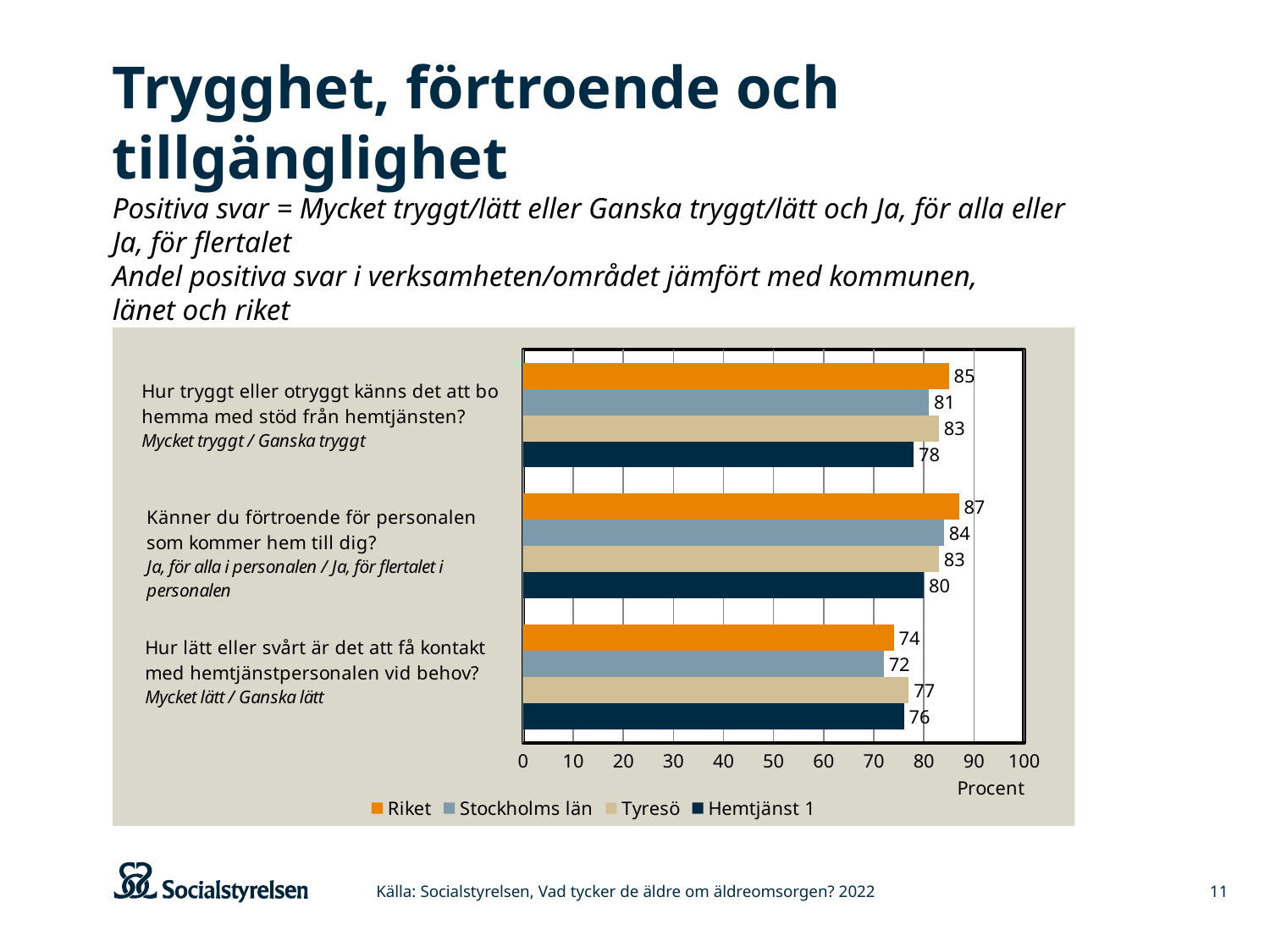
What is the difference between Riket and Hemtjänst 1 on the question "Hur tryggt eller otryggt känns det att bo hemma med stöd från hemtjänsten?"? 7 What is the value for Stockholms län on the question "Hur lätt eller svårt är det att få kontakt med hemtjänstpersonalen vid behov?"? 72 Is the value for Riket on the question "Känner du förtroende för personalen som kommer hem till dig?" greater or less than 80? greater What is the value for Tyresö on the question "Hur lätt eller svårt är det att få kontakt med hemtjänstpersonalen vid behov?"? 77 Which is larger on the question "Hur lätt eller svårt är det att få kontakt med hemtjänstpersonalen vid behov?": Tyresö or Riket? Tyresö What is the value for Riket on the question "Hur tryggt eller otryggt känns det att bo hemma med stöd från hemtjänsten?"? 85 Which series has the highest value on the question "Känner du förtroende för personalen som kommer hem till dig?"? Riket How many question categories are shown on the chart? 3 What is the value for Hemtjänst 1 on the question "Känner du förtroende för personalen som kommer hem till dig?"? 80 What kind of chart is shown on the slide? Bar chart Which series has the lowest value on the question "Hur tryggt eller otryggt känns det att bo hemma med stöd från hemtjänsten?"? Hemtjänst 1 How many series does the legend list? 4